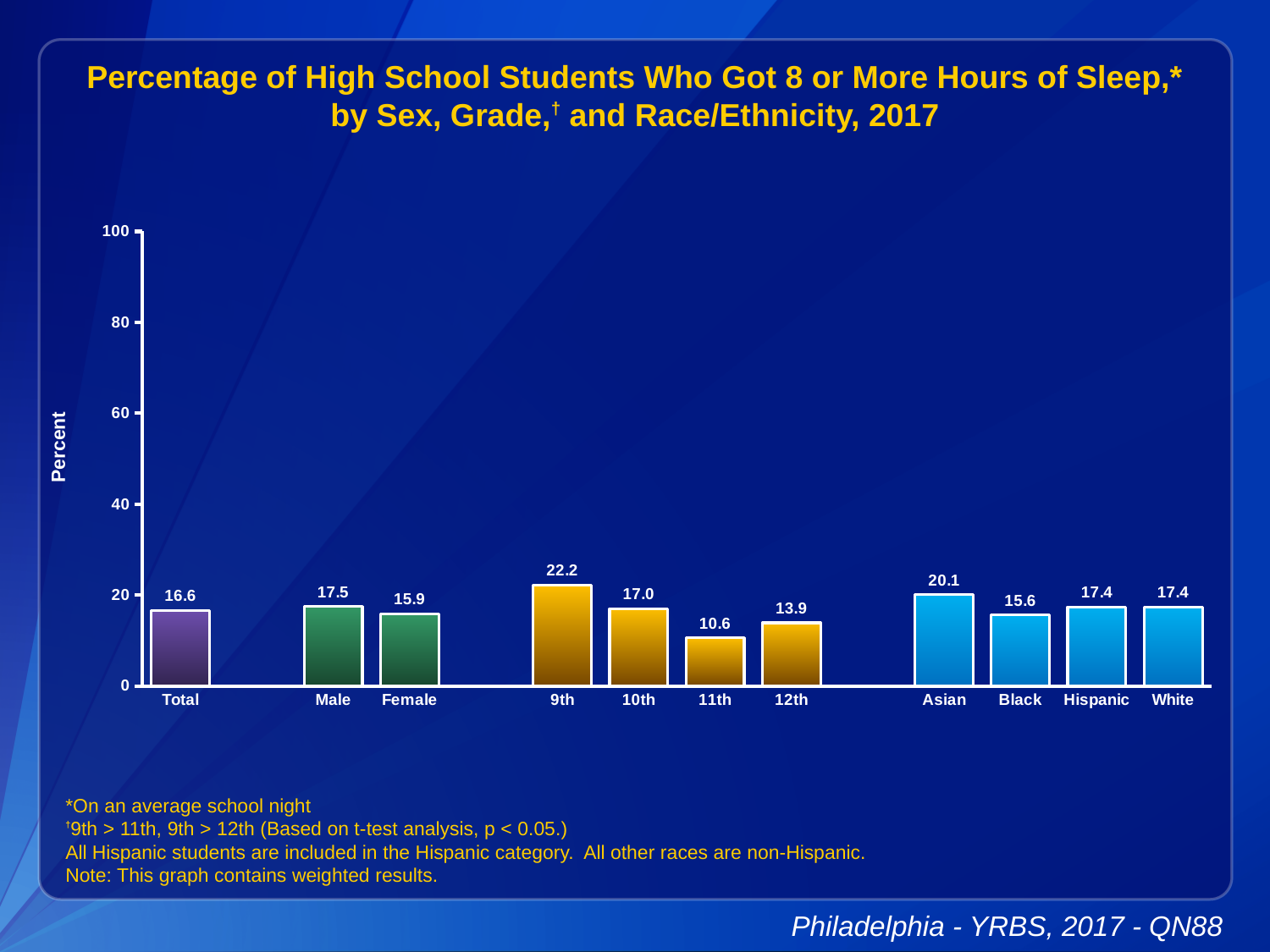
What is the difference between the values for Male and Female? 1.6 Which is larger, the value for Asian or the value for Black? Asian What percentage of 9th grade students got 8 or more hours of sleep? 22.2 Is the value for 9th grade greater or less than 20? greater Which category has the highest value on the chart? 9th What is the label on the y axis? Percent What is the value for Total? 16.6 What kind of chart is shown on the slide? bar chart What is the value for Asian students? 20.1 How many categories are plotted on the chart? 11 What is the difference between the values for 9th and 12th grade? 8.3 Which category has the lowest value on the chart? 11th